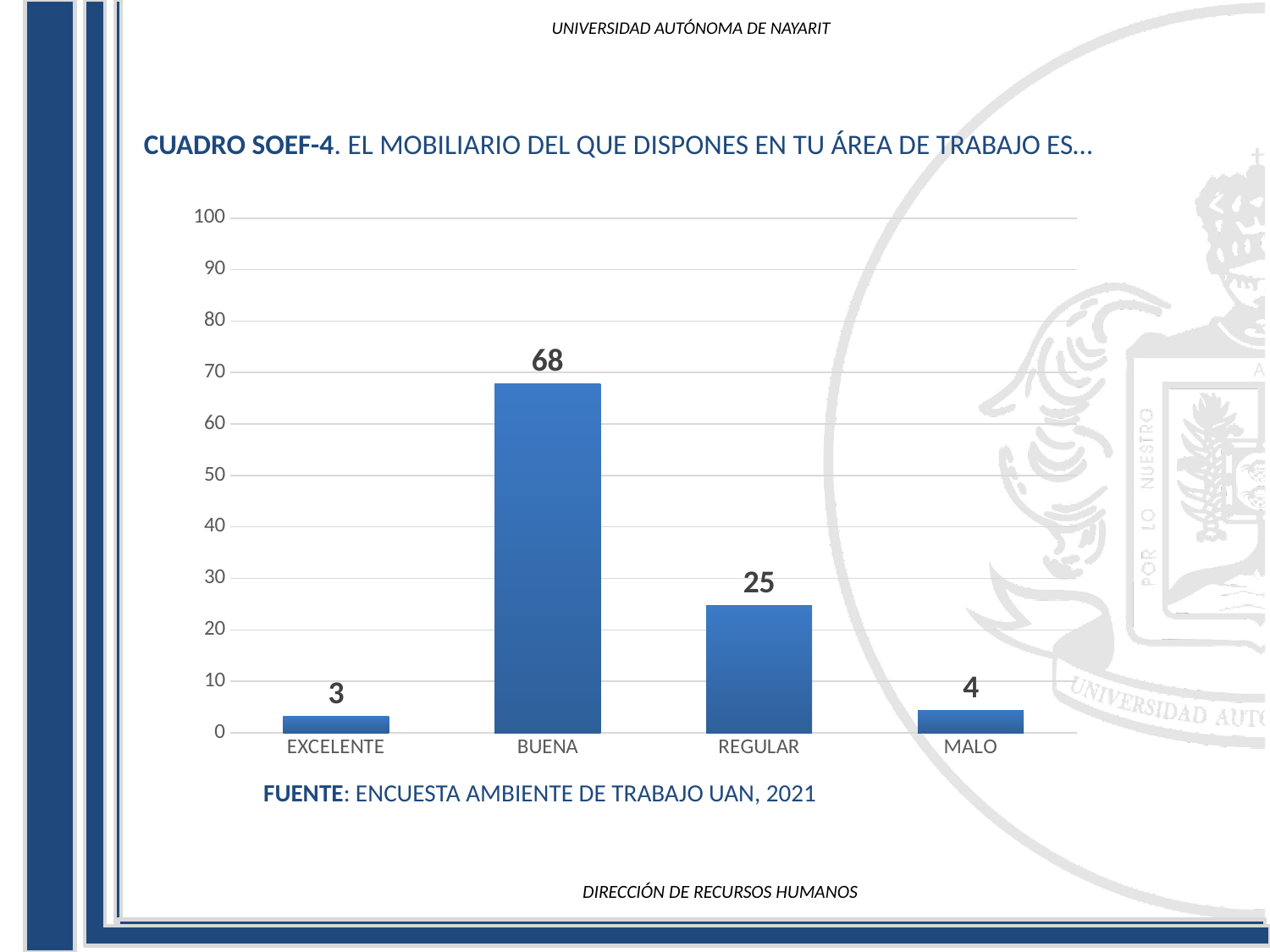
What is the value for EXCELENTE? 3 How many categories are shown on the x axis? 4 Which category has the lowest value? EXCELENTE Which is larger, the value for MALO or the value for EXCELENTE? MALO What is the value for MALO? 4 What is the value for REGULAR? 25 Is the value for BUENA greater or less than 50? greater What kind of chart is shown on the slide? bar chart Which category has the highest value? BUENA What is the difference between the values for BUENA and REGULAR? 43 What is the value for BUENA? 68 What source is cited below the chart? ENCUESTA AMBIENTE DE TRABAJO UAN, 2021